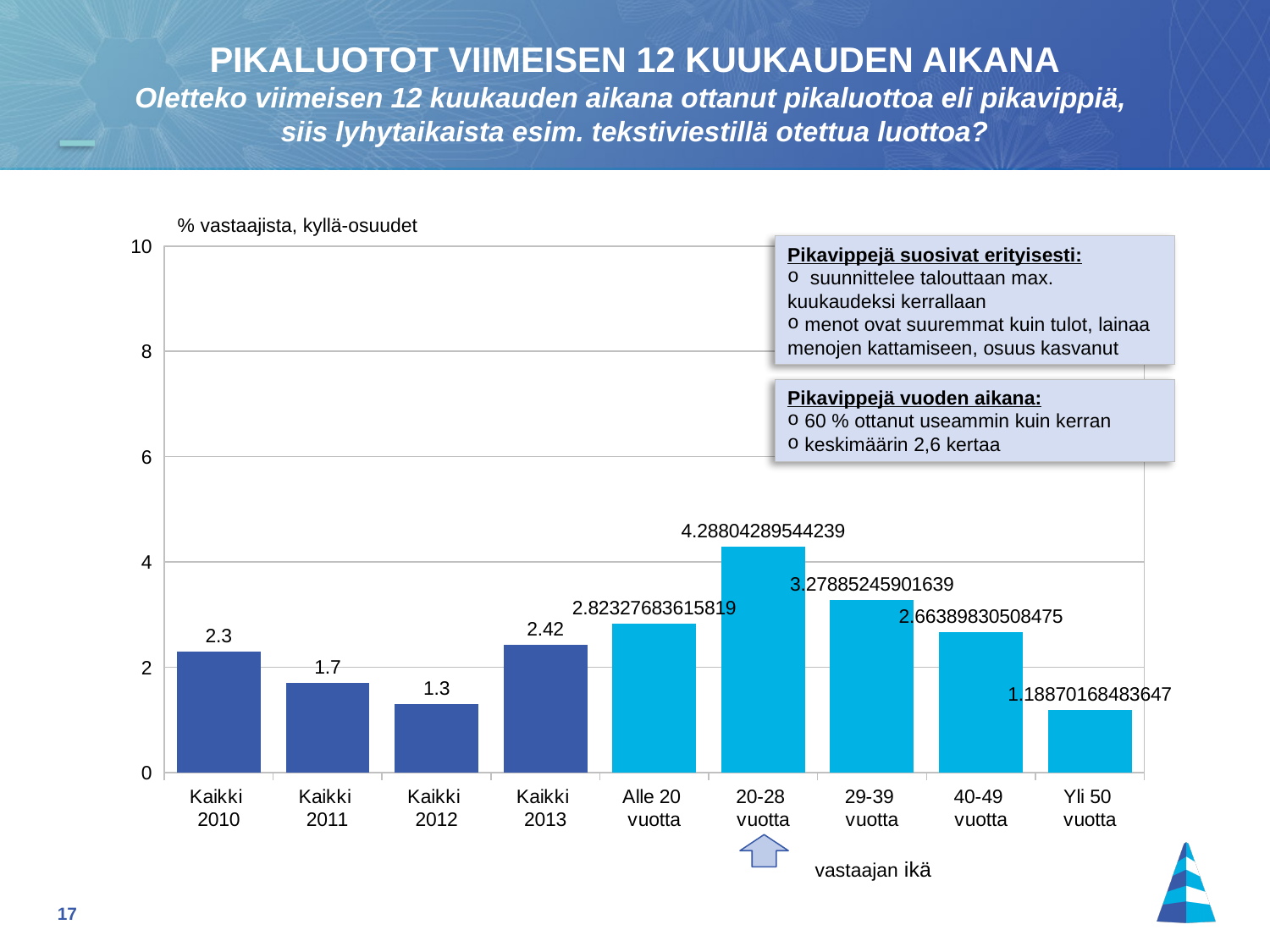
Do the values fall or rise from Kaikki 2010 to Kaikki 2012? fall What is the value for Yli 50 vuotta? 1.18870168483647 Is the value for 20-28 vuotta greater or less than 4? greater What is the value for 20-28 vuotta? 4.28804289544239 What kind of chart is shown on the slide? bar chart Which category has the lowest value? Yli 50 vuotta How many categories are shown on the x axis? 9 Which category has the highest value? 20-28 vuotta What is the value for Kaikki 2010? 2.3 Which is larger, the value for 29-39 vuotta or the value for 40-49 vuotta? 29-39 vuotta What is the value for Kaikki 2013? 2.42 What is the difference between Kaikki 2013 and Kaikki 2012? 1.12